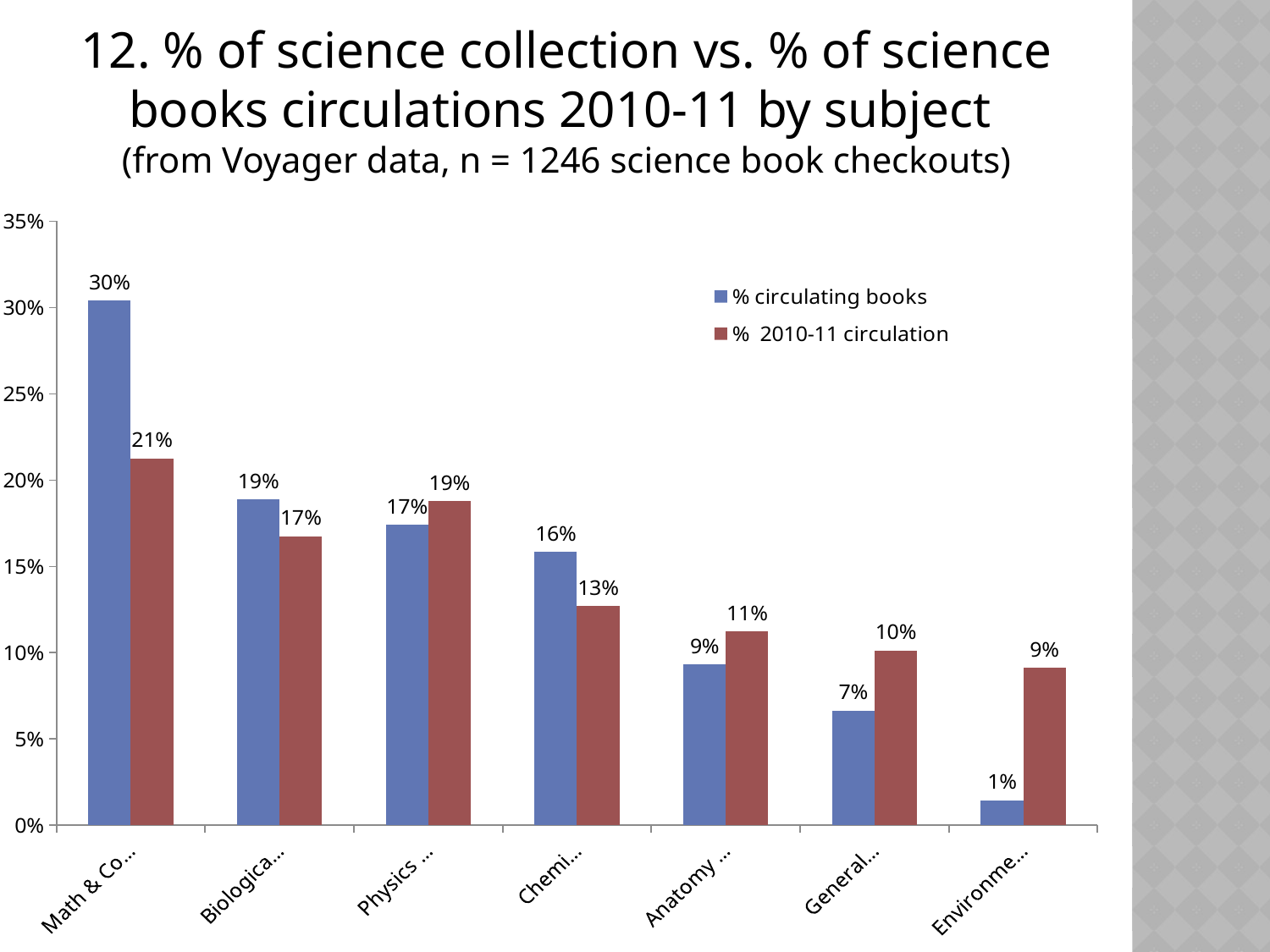
What kind of chart is shown on the slide? Bar chart For the Math & Co... category, what is the difference between % circulating books and % 2010-11 circulation? 9 percentage points For the Physics category, which series has the larger value: % circulating books or % 2010-11 circulation? % 2010-11 circulation How many series does the legend list? 2 Do the values for % circulating books rise or fall from left to right along the x axis? Fall Which category has the highest value for % circulating books? Math & Co... What colour represents the % 2010-11 circulation series? Red How many subject categories are shown on the x axis? 7 What is the value of % circulating books for the Math & Co... category? 30% What is the value of % 2010-11 circulation for the Environme... category? 9% Which category has the lowest value for % circulating books? Environme... What is the value of % 2010-11 circulation for the Anatomy category? 11%